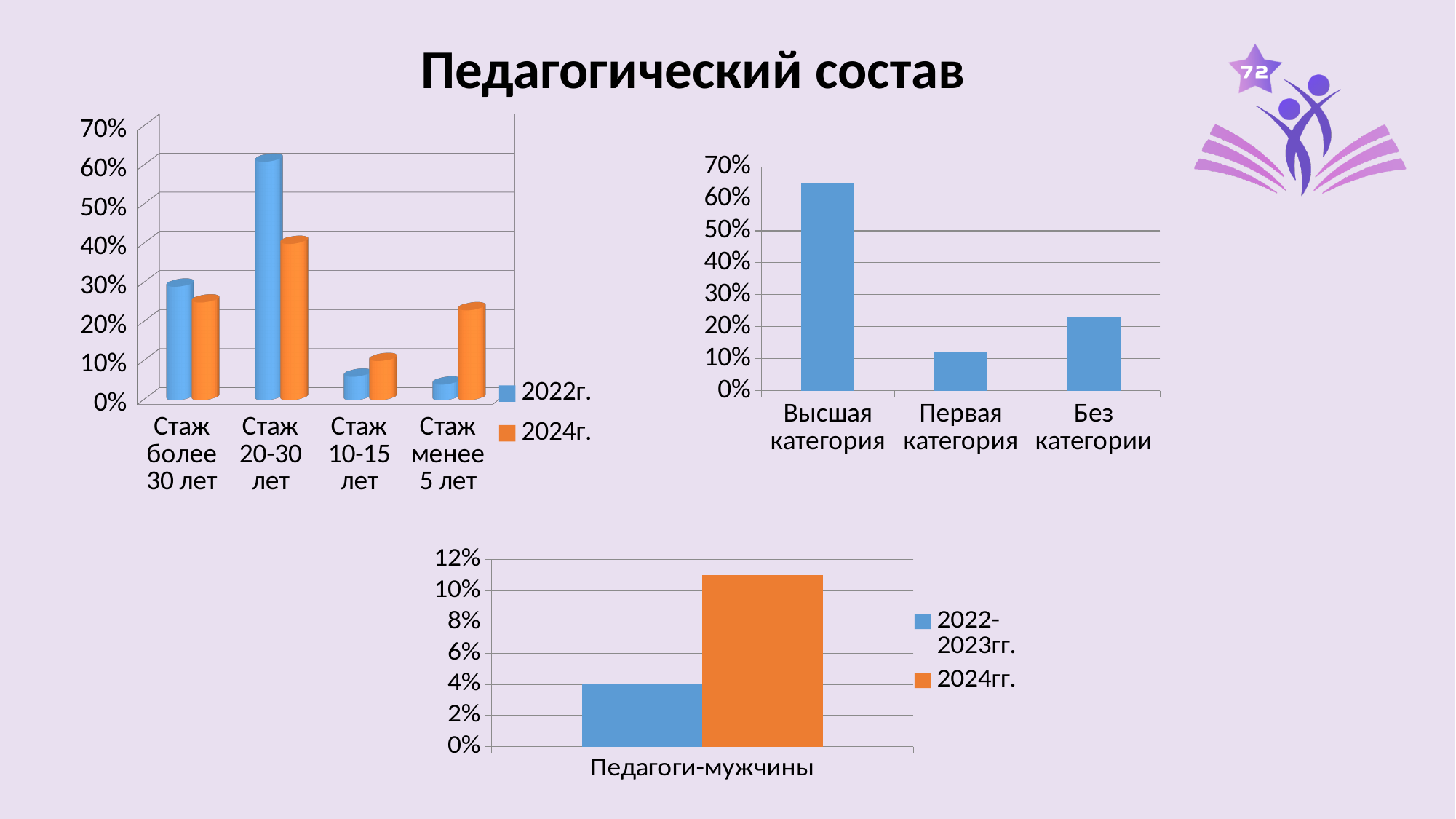
In the top-left chart, which category has the highest value for 2022г.? Стаж 20-30 лет In the top-right chart, is the value for Высшая категория greater or less than 60%? greater In the top-right chart, which category has the lowest value? Первая категория In the top-left chart, is the 2022г. value for Стаж 20-30 лет greater or less than 50%? greater In the top-left chart, which is larger for Стаж менее 5 лет: the 2022г. value or the 2024г. value? 2024г. In the top-left chart, which category has the lowest value for 2022г.? Стаж менее 5 лет In the top-right chart, which category has the highest value? Высшая категория How many categories are shown on the x axis of the top-left chart? 4 What kind of chart is the bottom chart (Педагоги-мужчины)? bar chart In the bottom chart (Педагоги-мужчины), what is the value for 2022-2023гг.? 4% In the top-left chart, is the 2024г. value for Стаж менее 5 лет greater or less than 10%? greater How many series does the legend of the top-left chart list? 2